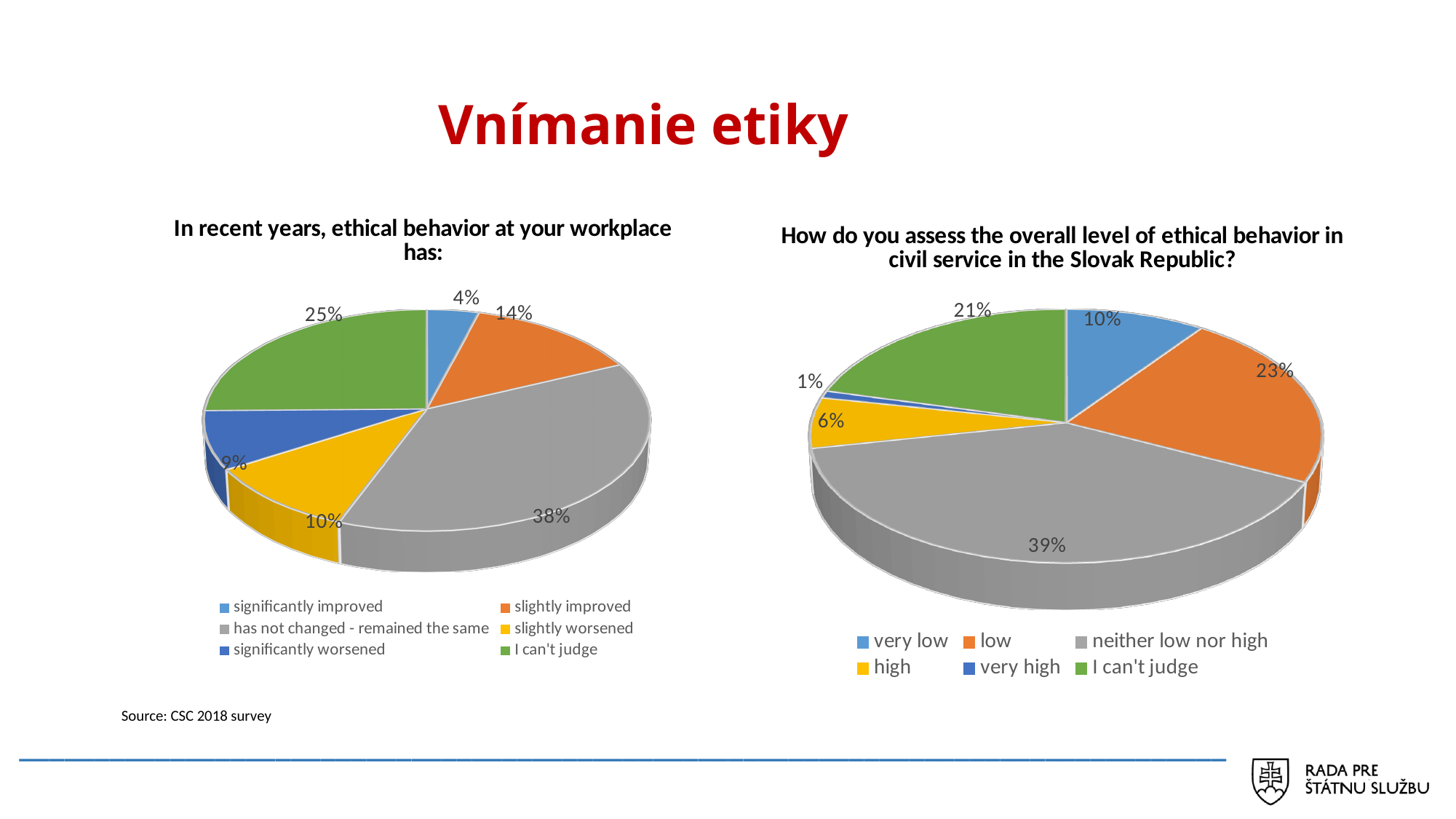
In the chart titled "In recent years, ethical behavior at your workplace has:", how many categories does the legend list? 6 In the chart titled "How do you assess the overall level of ethical behavior in civil service in the Slovak Republic?", what is the combined share of "very low" and "low"? 33% In the chart titled "In recent years, ethical behavior at your workplace has:", what share of respondents said ethical behavior significantly improved? 4% In the chart titled "How do you assess the overall level of ethical behavior in civil service in the Slovak Republic?", which is larger: the share for "very low" or the share for "high"? very low In the chart titled "In recent years, ethical behavior at your workplace has:", what share of respondents said ethical behavior has not changed - remained the same? 38% In the chart titled "In recent years, ethical behavior at your workplace has:", which category has the smallest slice? significantly improved In the chart titled "How do you assess the overall level of ethical behavior in civil service in the Slovak Republic?", what share of respondents answered "low"? 23% In the chart titled "How do you assess the overall level of ethical behavior in civil service in the Slovak Republic?", which category has the largest slice? neither low nor high In the chart titled "How do you assess the overall level of ethical behavior in civil service in the Slovak Republic?", what share of respondents answered "very high"? 1% In the chart titled "In recent years, ethical behavior at your workplace has:", which category has the largest slice? has not changed - remained the same What type of chart is used on the right side of the slide? Pie chart In the chart titled "In recent years, ethical behavior at your workplace has:", what is the difference between the shares for "I can't judge" and "slightly improved"? 11 percentage points